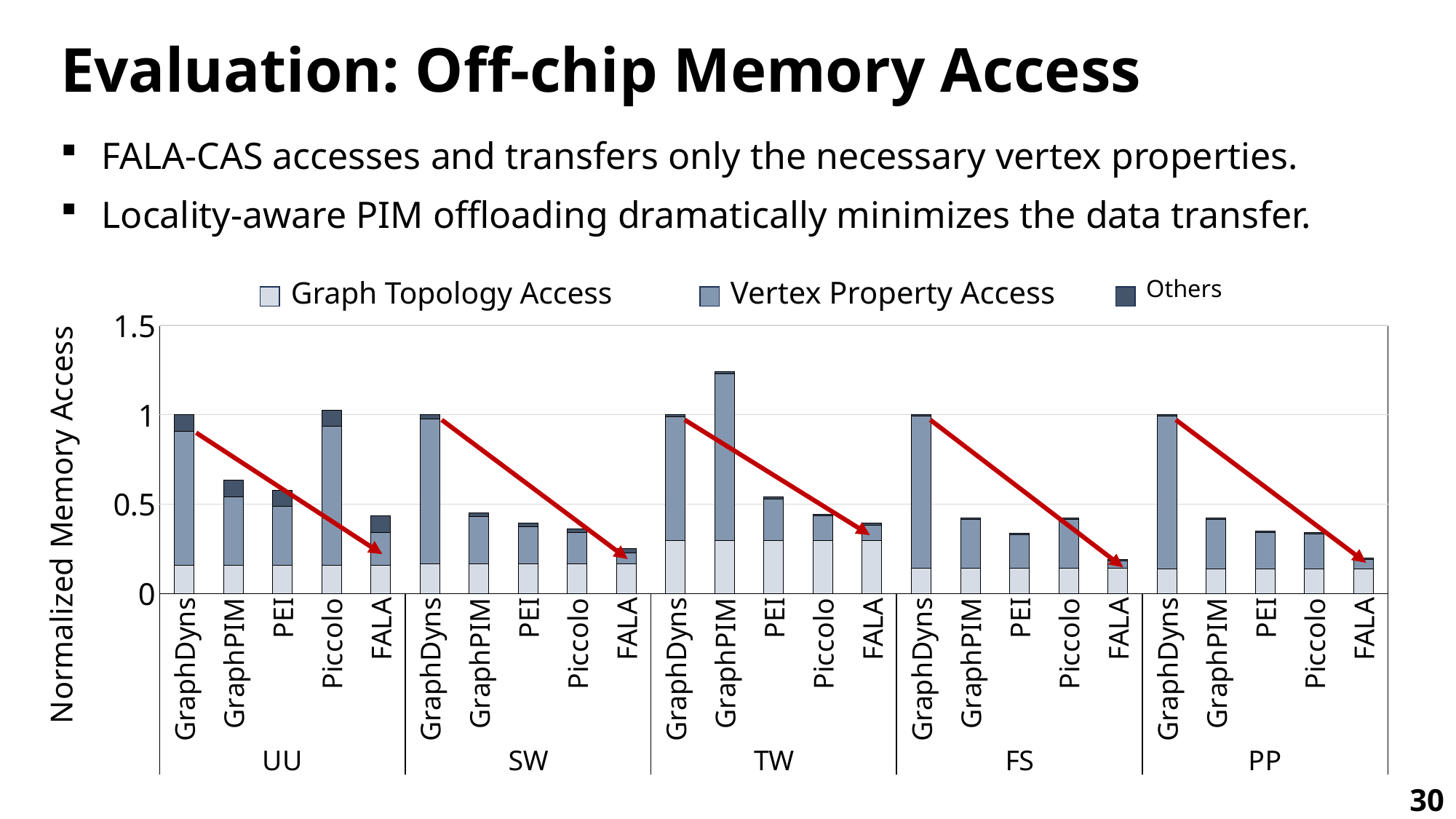
Is the total value for GraphPIM in the TW group greater or less than 1? greater Is the total value for FALA in the FS group greater or less than 0.5? less How many bars are plotted in total across all groups? 25 Within the SW group, which system has the lowest total normalized memory access? FALA In the TW group, which is larger: the total for GraphDyns or for GraphPIM? GraphPIM How many series does the legend list? 3 What is the label of the y axis? Normalized Memory Access Within the UU group, which system has the lowest total normalized memory access? FALA Which bar has the highest total normalized memory access in the whole chart? GraphPIM in TW What kind of chart is shown on the slide? stacked bar chart How many workload groups are shown along the x axis? 5 Is the total value for GraphDyns in the UU group greater or less than 0.5? greater